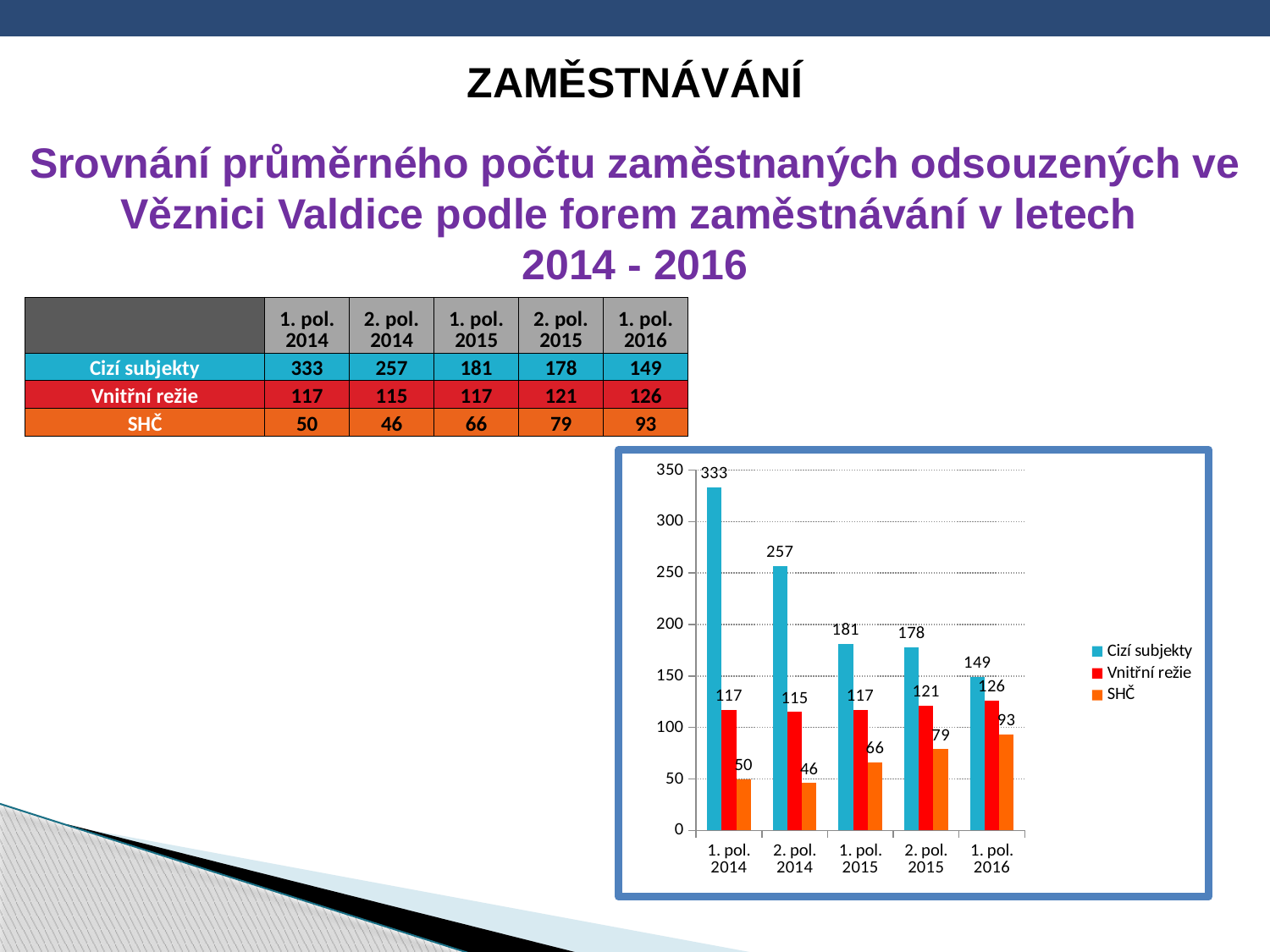
What is the value for SHČ in 2. pol. 2015? 79 What is the value for Cizí subjekty in 1. pol. 2014? 333 In which period is the value for Cizí subjekty lowest? 1. pol. 2016 Do the values for Cizí subjekty rise or fall from 1. pol. 2014 to 1. pol. 2016? Fall How many series does the chart legend list? 3 Which is larger in 1. pol. 2016: Cizí subjekty or Vnitřní režie? Cizí subjekty What is the difference between Cizí subjekty in 1. pol. 2014 and 2. pol. 2014? 76 How many periods are shown on the x axis of the chart? 5 In which period is the value for SHČ highest? 1. pol. 2016 What kind of chart is shown on the slide? Bar chart What is the value for Vnitřní režie in 1. pol. 2016? 126 What colour represents SHČ in the chart? Orange